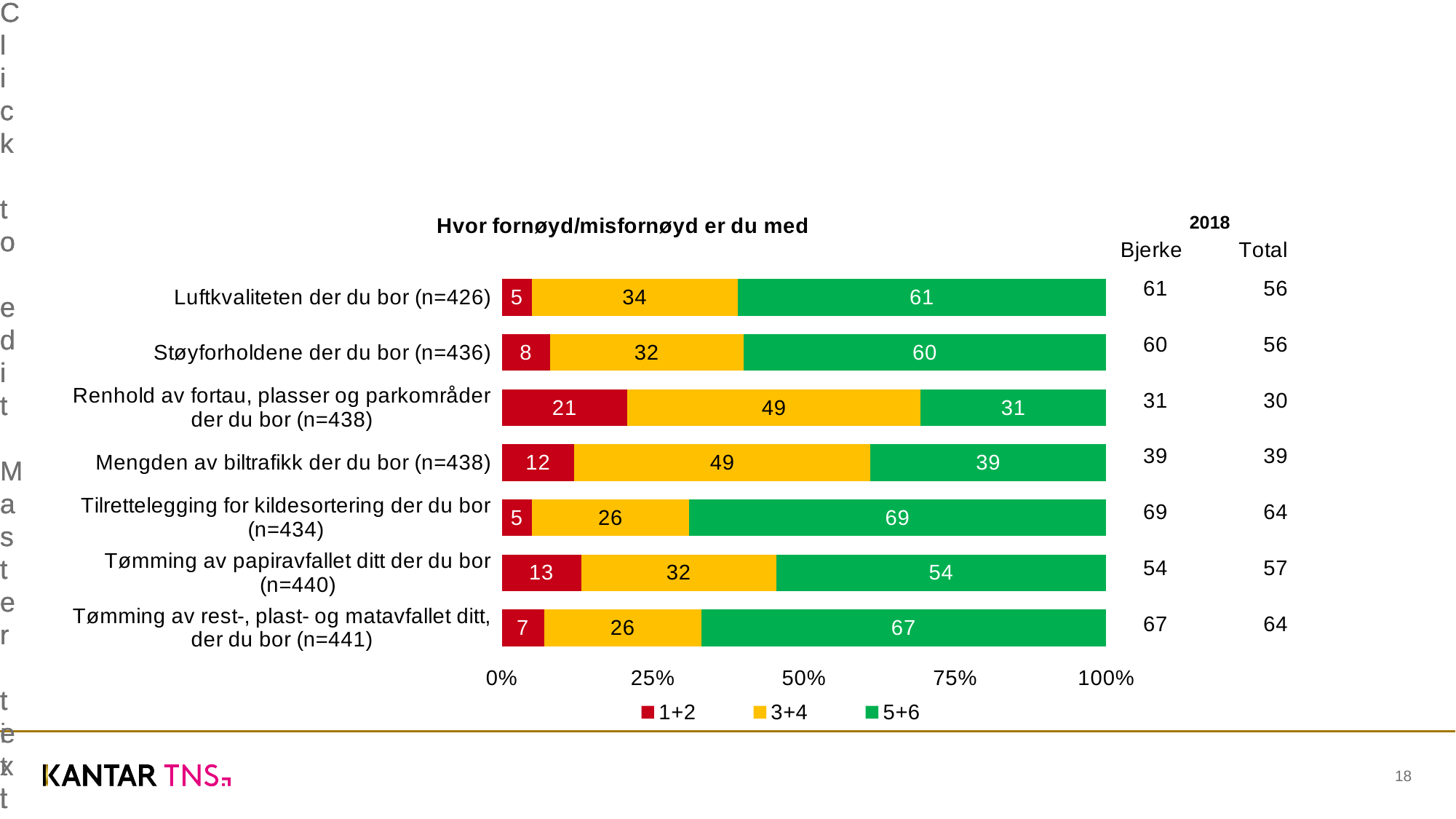
How many categories are shown in the chart? 7 What is the value of the 1+2 series for "Renhold av fortau, plasser og parkområder der du bor (n=438)"? 21 What is the difference between the 5+6 values for "Tilrettelegging for kildesortering der du bor (n=434)" and "Renhold av fortau, plasser og parkområder der du bor (n=438)"? 38 What is the value of the 3+4 series for "Mengden av biltrafikk der du bor (n=438)"? 49 Which category has the lowest value in the 5+6 series? Renhold av fortau, plasser og parkområder der du bor (n=438) Which has a larger 5+6 value: "Tømming av papiravfallet ditt der du bor (n=440)" or "Tømming av rest-, plast- og matavfallet ditt, der du bor (n=441)"? Tømming av rest-, plast- og matavfallet ditt, der du bor (n=441) What is the value of the 5+6 series for "Luftkvaliteten der du bor (n=426)"? 61 What kind of chart is shown on the slide? Stacked bar chart Which category has the highest value in the 5+6 series? Tilrettelegging for kildesortering der du bor (n=434) What is the title of the chart? Hvor fornøyd/misfornøyd er du med Which category has the highest value in the 1+2 series? Renhold av fortau, plasser og parkområder der du bor (n=438) How many series does the legend list? 3